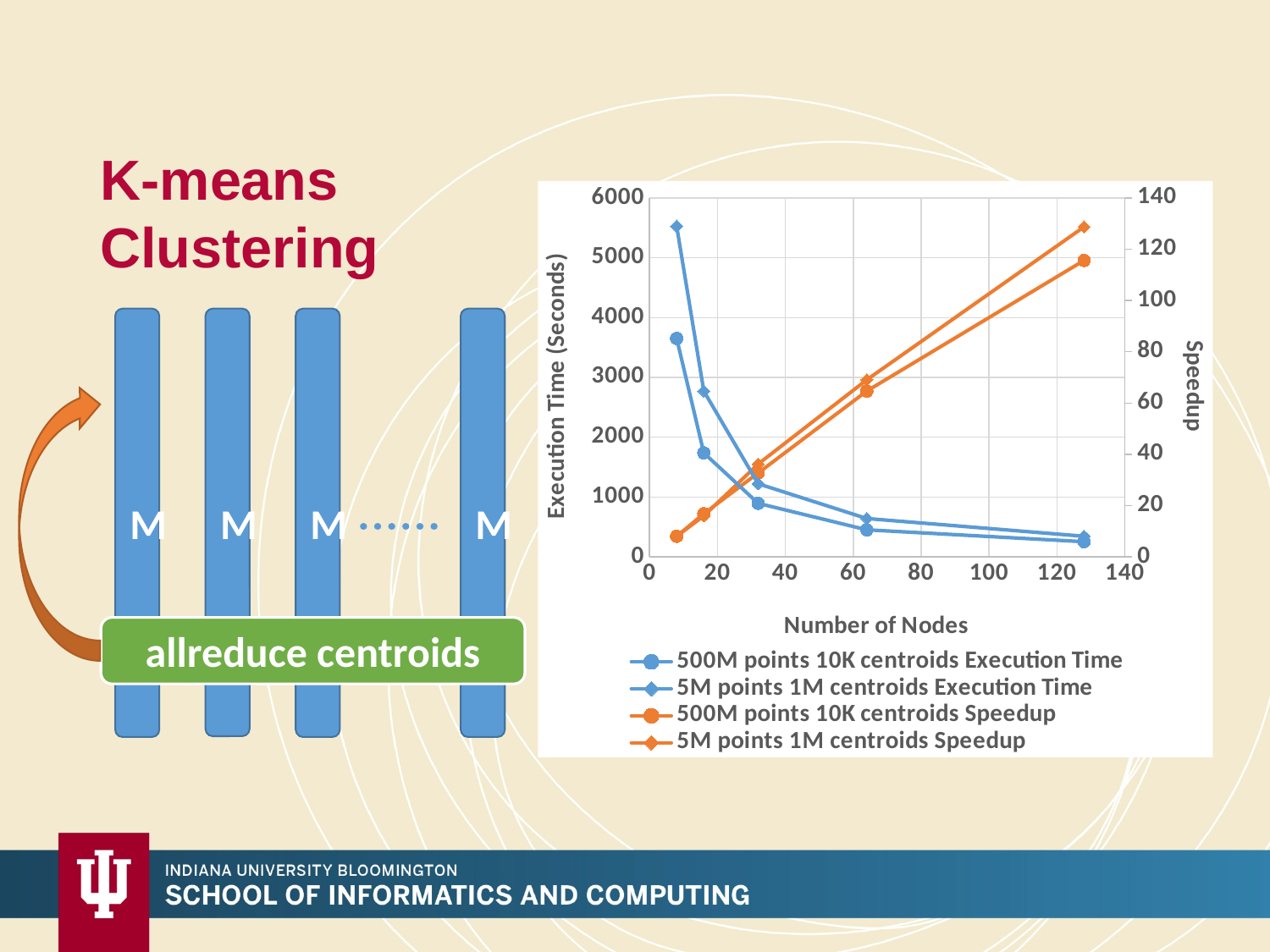
Is the execution time for 500M points 10K centroids at the smallest number of nodes greater or less than 4000 seconds? less At the smallest number of nodes, which series has the higher execution time: 500M points 10K centroids or 5M points 1M centroids? 5M points 1M centroids At the largest number of nodes, which series has the higher speedup: 500M points 10K centroids or 5M points 1M centroids? 5M points 1M centroids Do the execution time series rise or fall as the number of nodes increases? fall What kind of chart is shown on the slide? line chart Do the speedup series rise or fall as the number of nodes increases? rise What is the label of the left y axis of the chart? Execution Time (Seconds) How many series does the chart legend list? 4 Is the execution time for 5M points 1M centroids at the smallest number of nodes greater or less than 5000 seconds? greater How many data points are plotted for the 500M points 10K centroids Execution Time series? 5 What is the label of the x axis of the chart? Number of Nodes Is the speedup for 5M points 1M centroids at the largest number of nodes greater or less than 120? greater